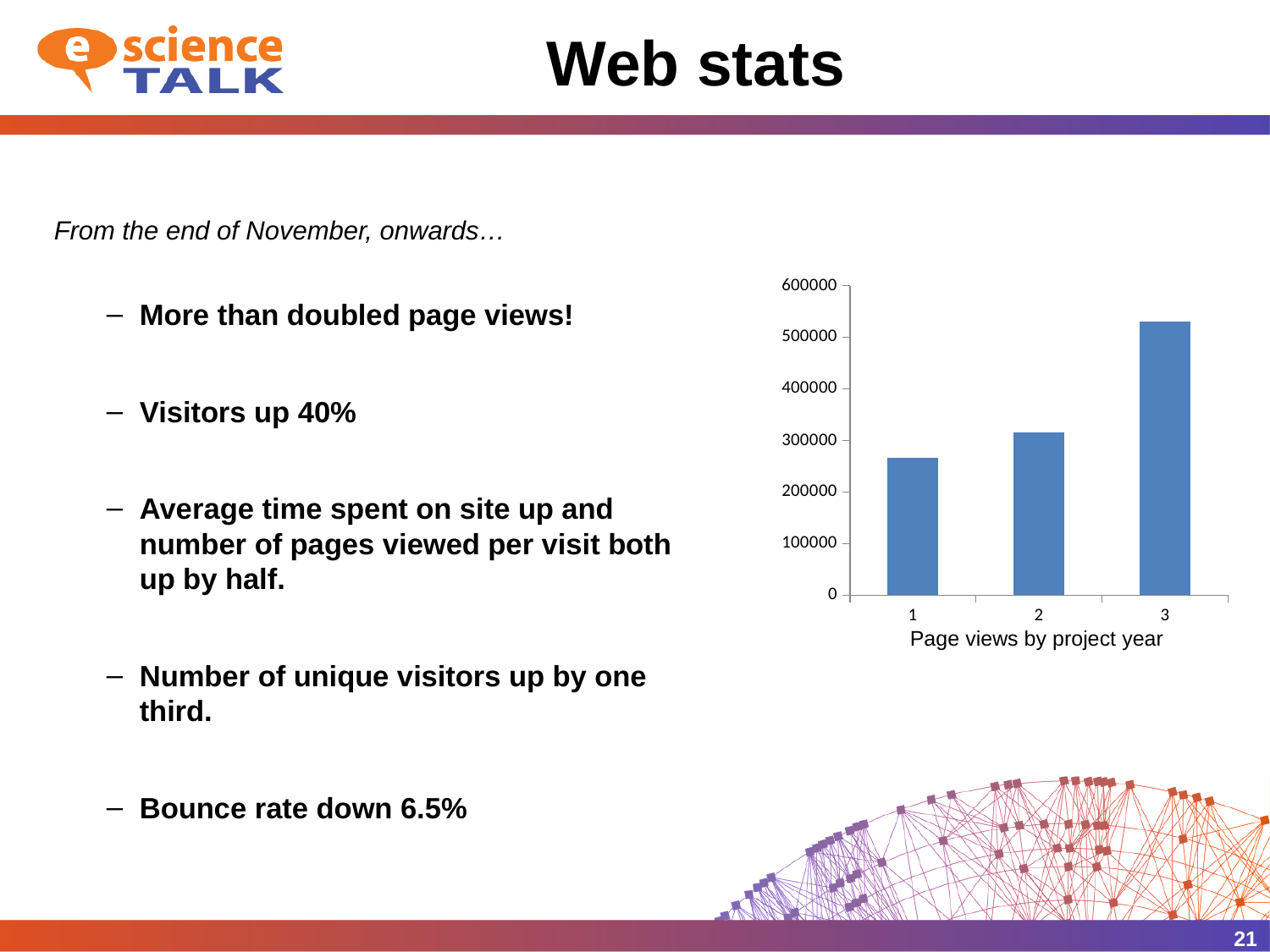
What is the label shown beneath the x axis of the chart? Page views by project year Which has more page views, project year 1 or project year 2? 2 What kind of chart is shown on the slide? bar chart Which project year has the highest page views in the chart? 3 Is the value for project year 3 greater or less than 500000? greater Which has more page views, project year 2 or project year 3? 3 Is the value for project year 1 greater or less than 200000? greater Do the page views rise or fall from project year 1 to project year 3? rise Is the value for project year 1 greater or less than 300000? less Which project year has the lowest page views in the chart? 1 How many bars are plotted in the chart? 3